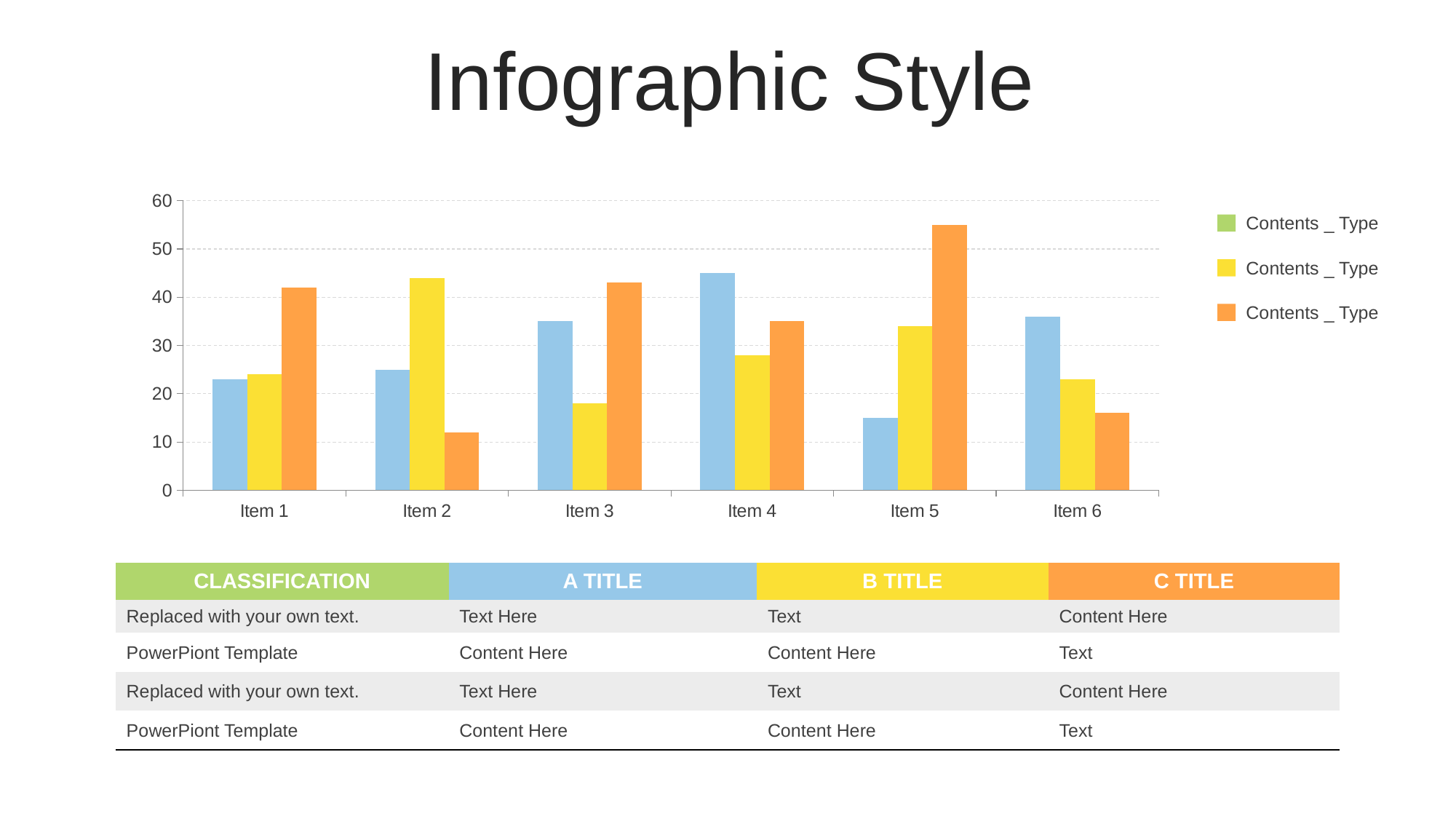
Is the value of the orange bar for Item 2 greater or less than 20? less Is the value of the orange bar for Item 5 greater or less than 50? greater What text is used for each entry in the chart's legend? Contents _ Type For Item 4, which is larger: the blue bar or the yellow bar? the blue bar How many categories are shown on the x axis of the chart? 6 Which category has the tallest blue bar? Item 4 What kind of chart is shown on the slide? bar chart How many series does the chart's legend list? 3 Which category has the tallest orange bar? Item 5 Is the value of the blue bar for Item 3 greater or less than 30? greater For Item 2, which is larger: the yellow bar or the orange bar? the yellow bar Which category has the shortest orange bar? Item 2